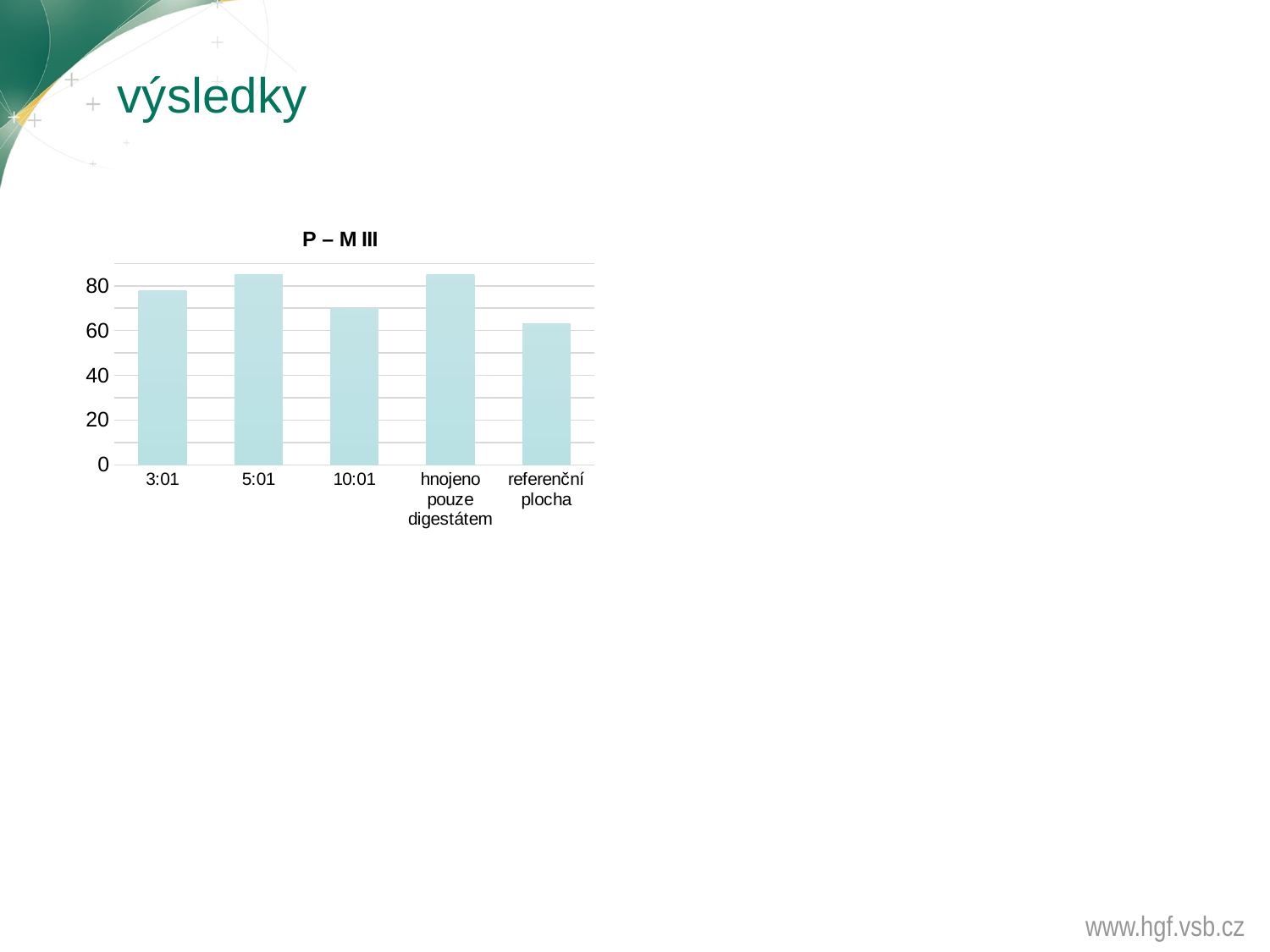
Is the value for 10:01 greater or less than 80? less What is the title of the chart? P – M III Which is larger, the value for 3:01 or the value for 10:01? 3:01 How many categories are shown on the x axis of the chart? 5 Which category has the lowest value in the chart? referenční plocha Which is larger, the value for 10:01 or the value for referenční plocha? 10:01 Which is larger, the value for 5:01 or the value for 3:01? 5:01 Is the value for 3:01 greater or less than 60? greater What kind of chart is shown on the slide? bar chart Is the value for 5:01 greater or less than 80? greater